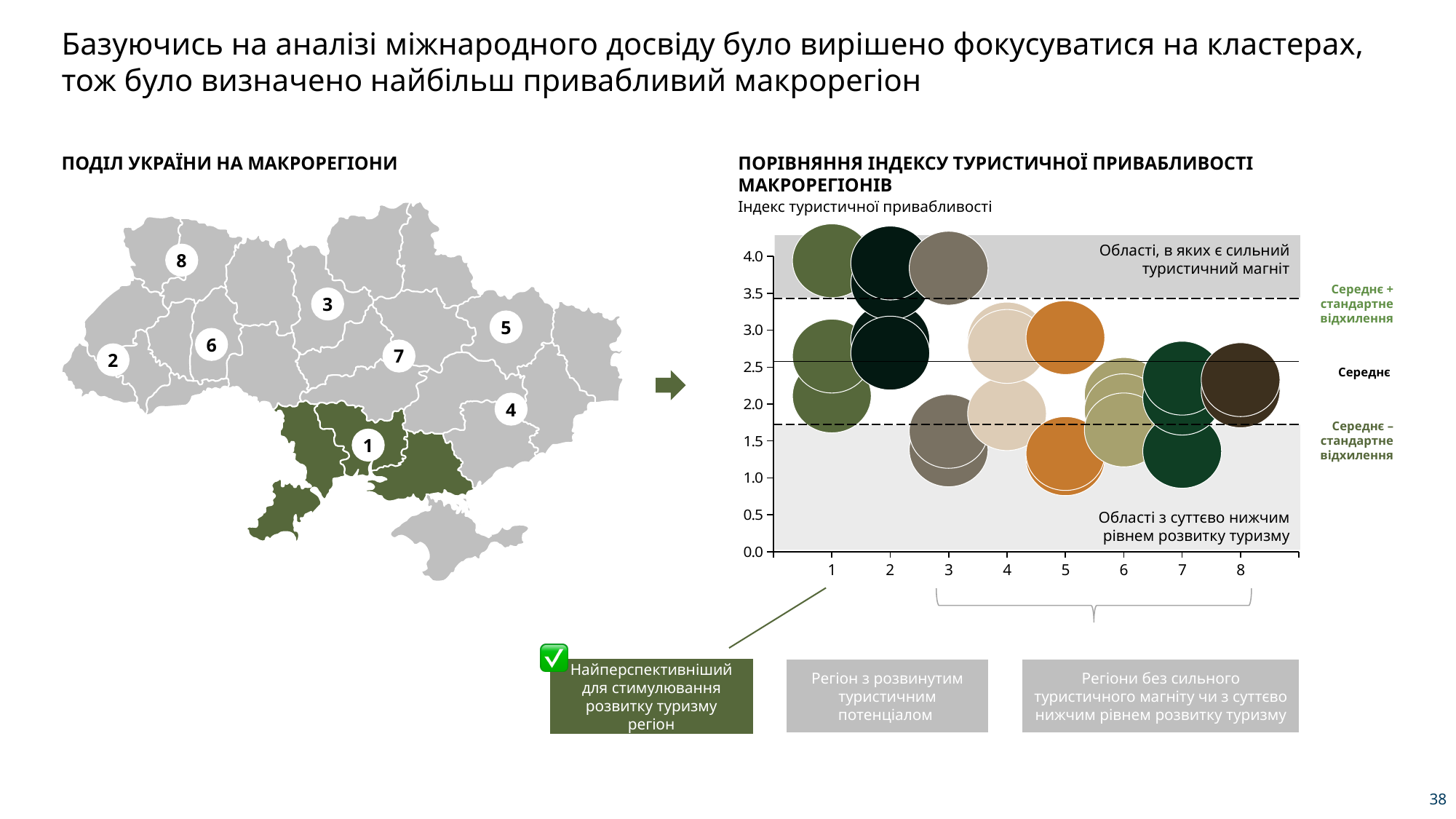
Which macroregion number is highlighted in green on the map of Ukraine? 1 What kind of chart is used to compare the tourism attractiveness index of the macroregions? Bubble (scatter) chart Is the value of the bubble for macroregion 8 greater or less than 3.0? less How many macroregions are shown along the x axis of the tourism attractiveness index chart? 8 What is the label of the y axis on the tourism attractiveness index chart? Індекс туристичної привабливості What is the highest tick value on the y axis of the tourism attractiveness index chart? 4.0 Is the value of the lowest bubble for macroregion 5 greater or less than 2.0? less Is the value of the highest bubble for macroregion 7 greater or less than 3.0? less